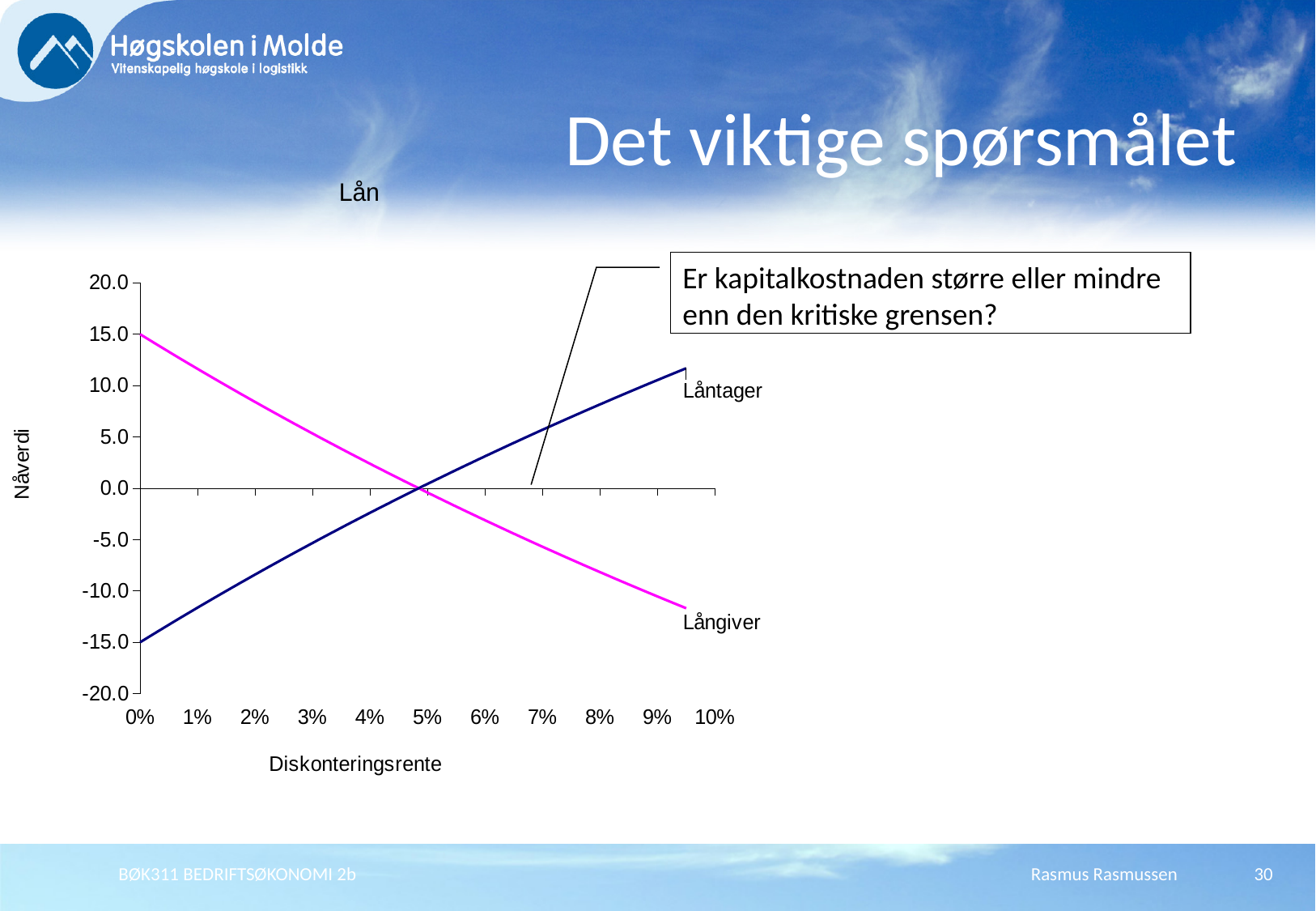
Is the Nåverdi of Låntager at 8% greater or less than 5.0? greater Is the Nåverdi of Långiver at 2% greater or less than 5.0? greater How many series are plotted in the chart? 2 Does the Låntager line rise or fall as the discount rate (Diskonteringsrente) increases? rises What is the Nåverdi of Låntager at a discount rate of 0%? -15.0 At a discount rate of 0%, which series has the higher Nåverdi, Låntager or Långiver? Långiver Is the Nåverdi of Långiver at 8% greater or less than -5.0? less What is the Nåverdi of Långiver at a discount rate of 0%? 15.0 At a discount rate of 9%, which series has the higher Nåverdi, Låntager or Långiver? Låntager What kind of chart is shown on the slide? line chart Does the Långiver line rise or fall as the discount rate (Diskonteringsrente) increases? falls What is the title of the chart? Lån